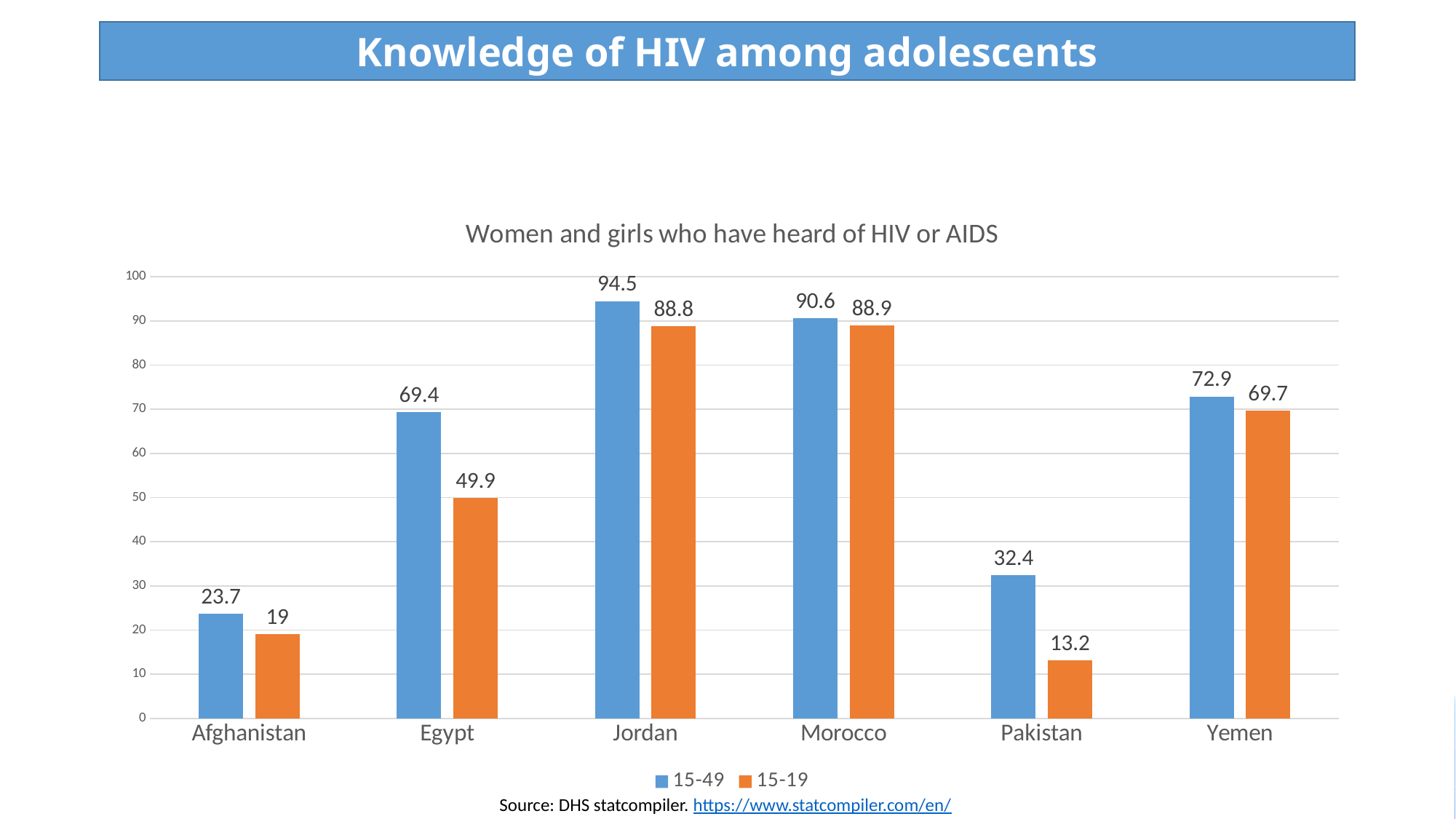
Which country has the lowest value for the 15-19 series? Pakistan Which country has the highest value for the 15-49 series? Jordan What kind of chart is shown? Bar chart How many series does the legend list? 2 What is the value for the 15-19 series in Egypt? 49.9 What is the difference between the 15-49 and 15-19 values for Egypt? 19.5 What is the value for the 15-19 series in Pakistan? 13.2 How many countries are shown on the x axis? 6 What is the value for the 15-49 series in Jordan? 94.5 Is the 15-49 value for Yemen greater or less than 70? greater Which is larger in Morocco: the 15-49 value or the 15-19 value? 15-49 What is the title of the chart? Women and girls who have heard of HIV or AIDS